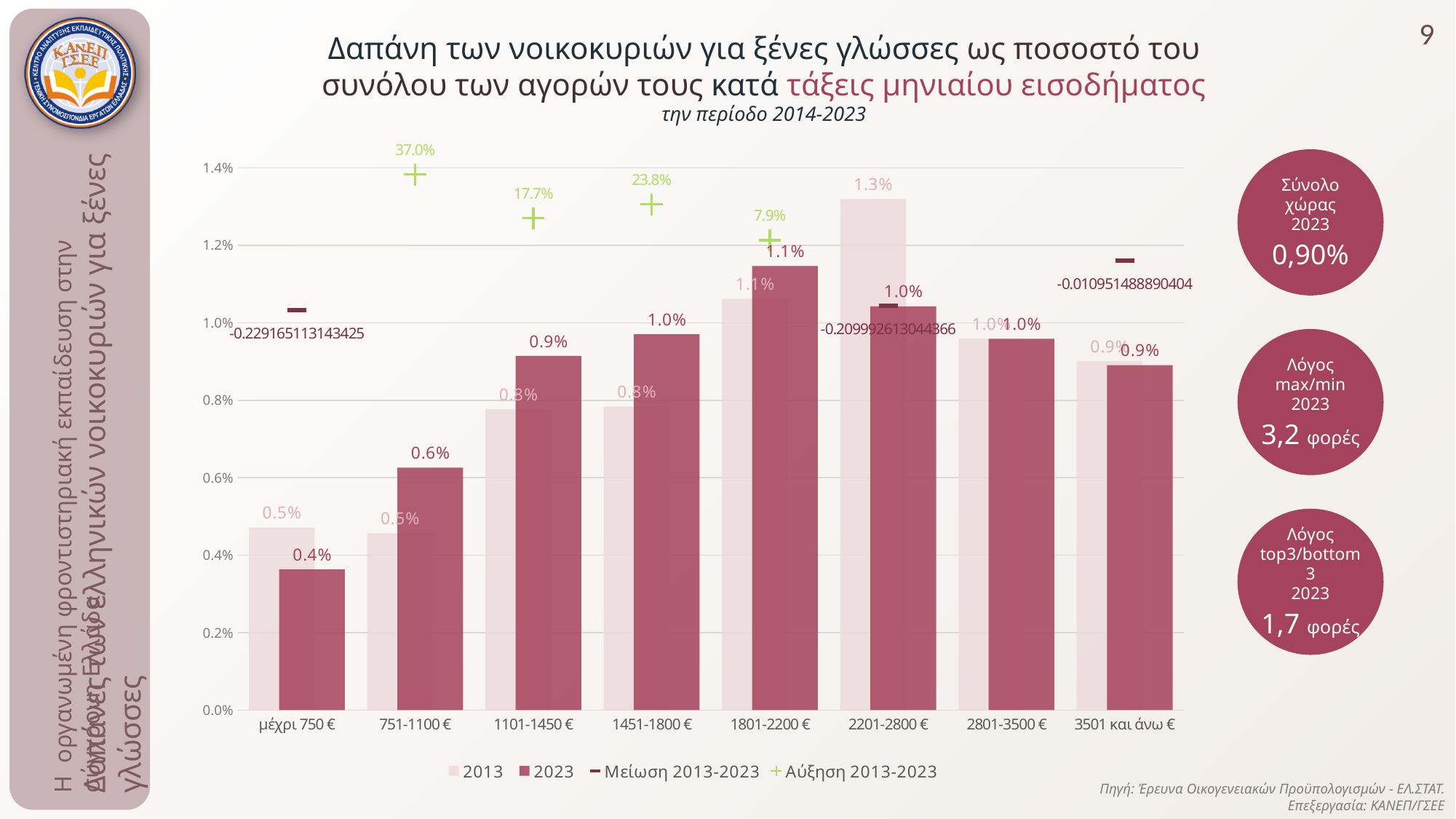
Is the 2013 value for '2201-2800 €' greater or less than 1.2%? greater What is the 2023 value for the income class '751-1100 €'? 0.6% What kind of chart is shown on the slide? bar chart What is the 2013 value for the income class '2201-2800 €'? 1.3% What is the 2023 value for the income class 'μέχρι 750 €'? 0.4% Which income class has the lowest 2023 value? μέχρι 750 € How many income classes are shown on the x axis? 8 For the income class '751-1100 €', which is larger: the 2013 value or the 2023 value? 2023 Which income class has the highest 2013 value? 2201-2800 € Which income class shows the largest 'Αύξηση 2013-2023' marker value? 751-1100 € How many series does the legend list? 4 What is the 'Αύξηση 2013-2023' value shown for the income class '1451-1800 €'? 23.8%